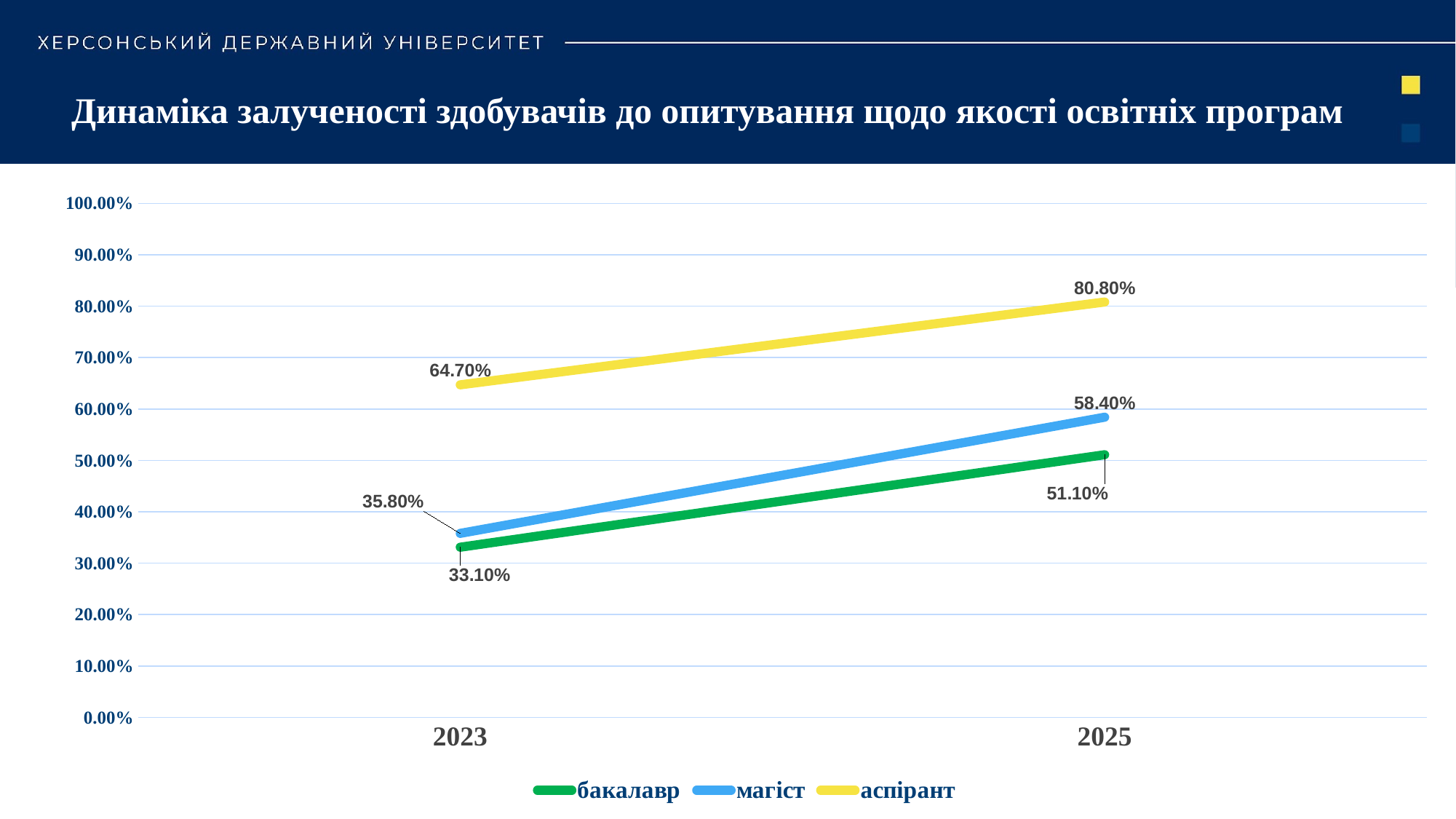
What is the difference between the магіст and бакалавр values in 2025? 7.30% What is the value for магіст in 2025? 58.40% What is the value for магіст in 2023? 35.80% What is the difference between the аспірант values in 2025 and 2023? 16.10% Which series has the highest value in 2025? аспірант Which is larger: the бакалавр value in 2025 or the аспірант value in 2023? аспірант value in 2023 Does the бакалавр series rise or fall from 2023 to 2025? rise Which series has the lowest value in 2023? бакалавр What is the value for бакалавр in 2023? 33.10% How many series does the legend list? 3 What kind of chart is shown on the slide? line chart What is the value for аспірант in 2025? 80.80%